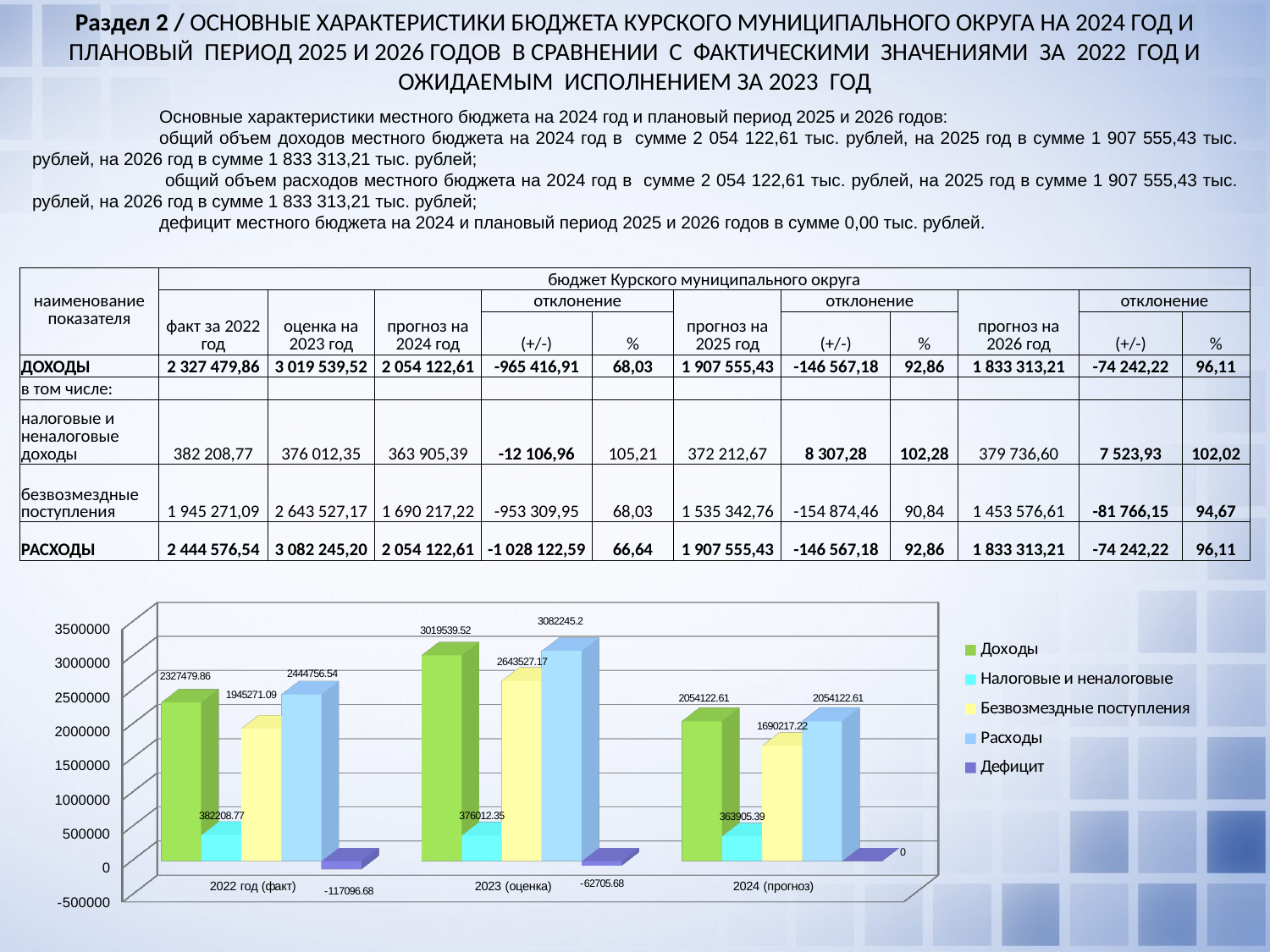
How many categories (years) are shown on the x axis of the chart? 3 What type of chart is shown on the slide? bar chart What is the value of Расходы for 2022 год (факт) in the chart? 2444756.54 In which year is the Налоговые и неналоговые value lowest in the chart? 2024 (прогноз) Which is larger in the chart for 2023 (оценка): Доходы or Расходы? Расходы How many series does the chart legend list? 5 What is the value of Доходы for 2023 (оценка) in the chart? 3019539.52 In which year is the Доходы value highest in the chart? 2023 (оценка) What is the value of Безвозмездные поступления for 2024 (прогноз) in the chart? 1690217.22 What is the difference between Расходы and Доходы for 2022 год (факт) in the chart? 117276.68 What is the value of Дефицит for 2023 (оценка) in the chart? -62705.68